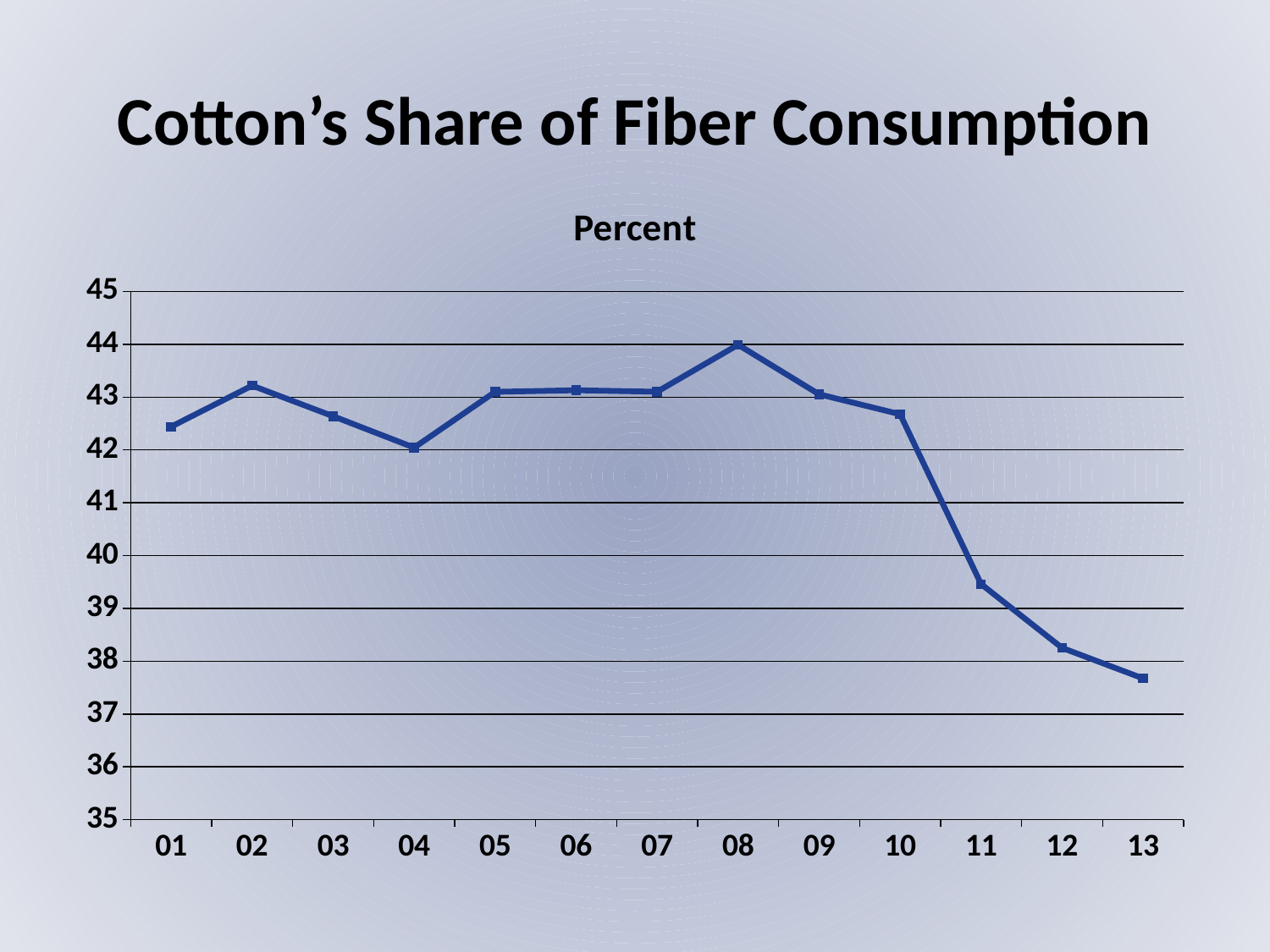
In which year is cotton's share of fiber consumption lowest? 13 What is the title of the chart on the slide? Cotton's Share of Fiber Consumption Is the value for 10 greater or less than 42? greater Is the value for 13 greater or less than 38? less Do the values rise or fall from 10 to 13? fall What kind of chart is shown on the slide? line chart Which year has the larger value, 02 or 04? 02 In which year is cotton's share of fiber consumption highest? 08 How many years are plotted along the x axis? 13 Is the value for 08 greater or less than 43? greater What unit label appears above the chart's plot area? Percent